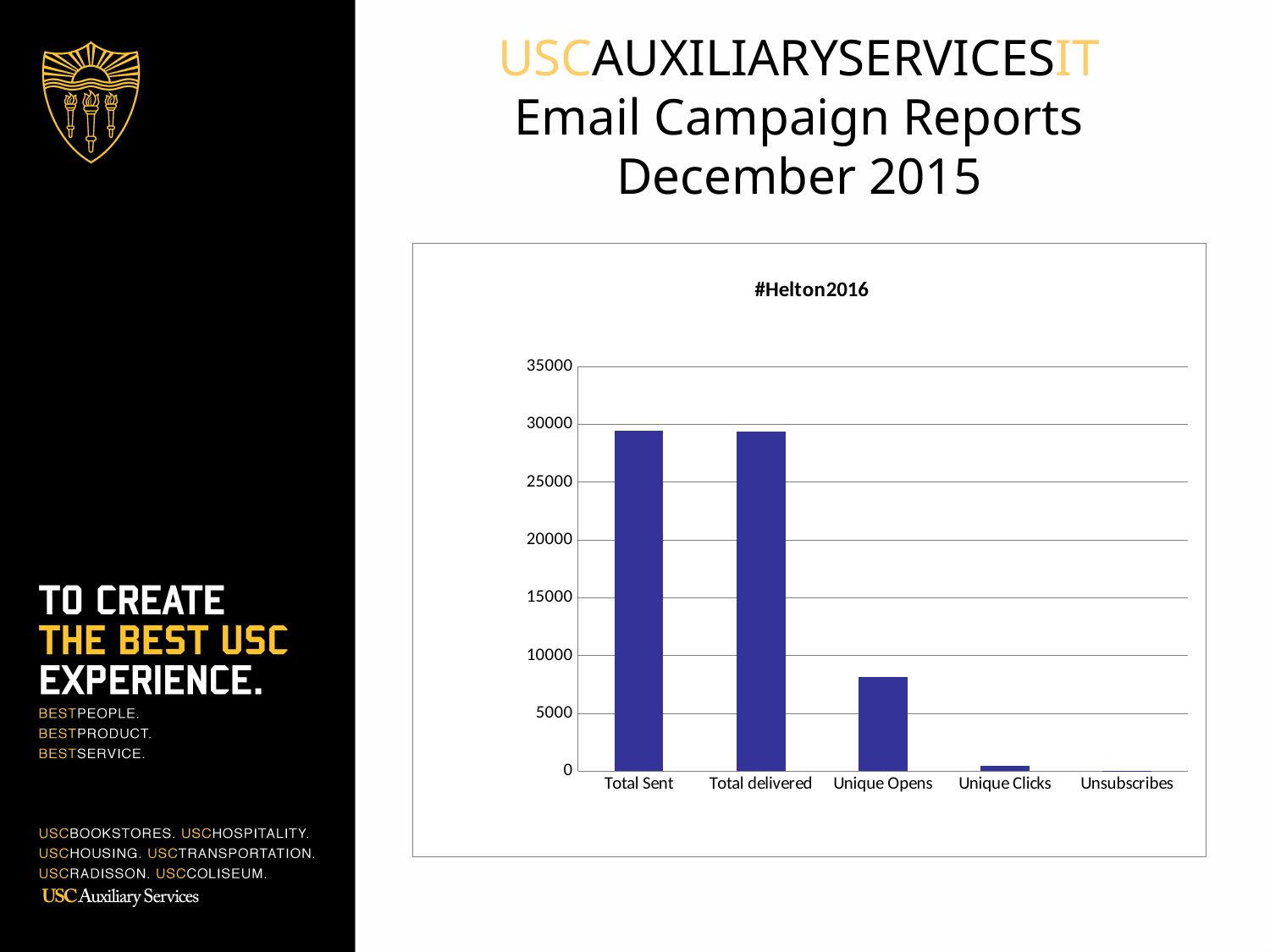
How many categories are shown on the x axis of the chart? 5 Is the value for Total delivered greater or less than 30000? less What kind of chart is shown on the slide? bar chart Which is larger, the value for Unique Opens or the value for Unique Clicks? Unique Opens Is the value for Unique Opens greater or less than 5000? greater Do the values rise or fall moving from left to right along the x axis? fall Which is larger, the value for Total Sent or the value for Unique Opens? Total Sent Is the value for Unique Opens greater or less than 10000? less What is the title of the chart? #Helton2016 Which category has the lowest value in the chart? Unsubscribes